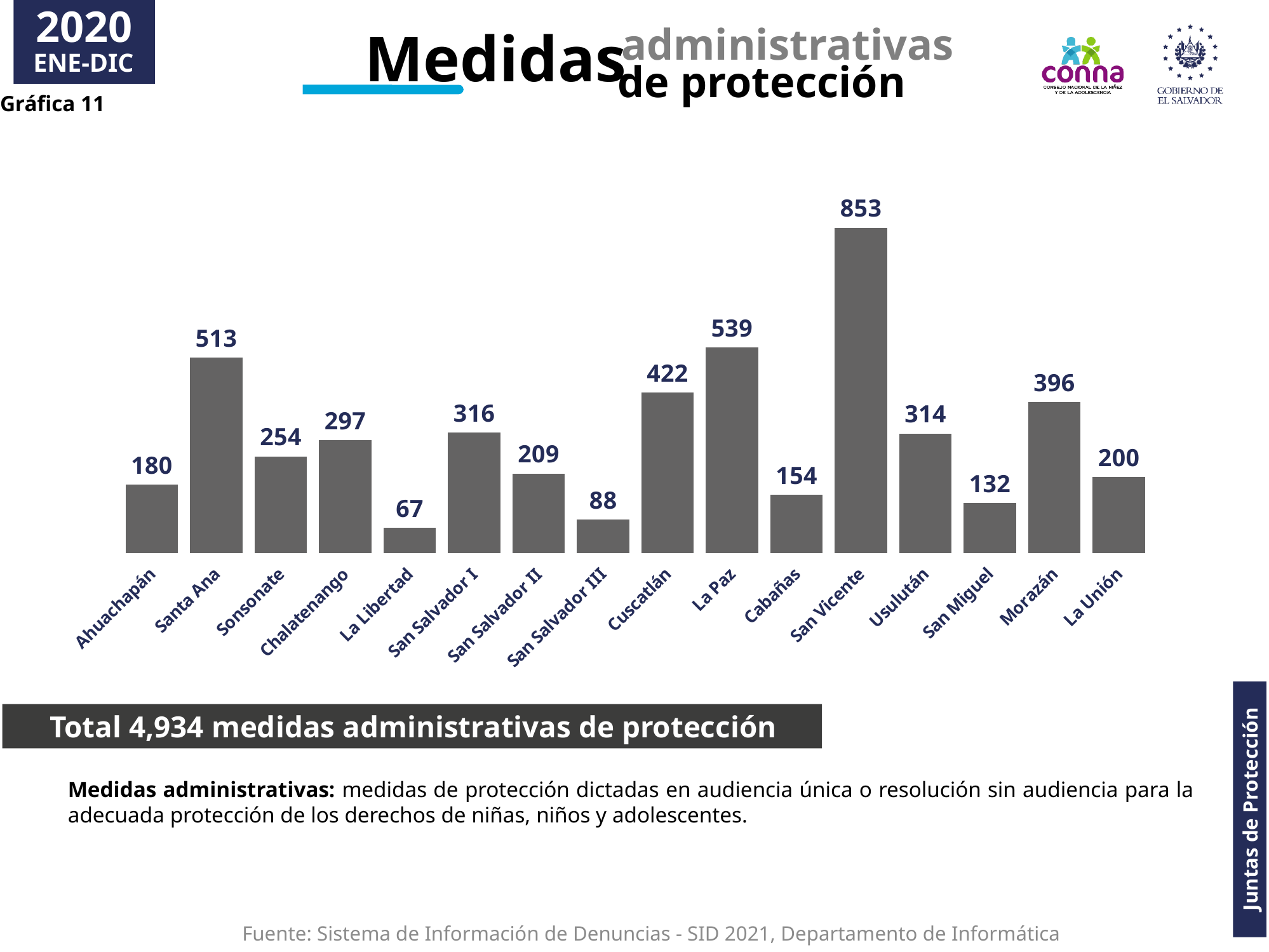
Which department has the highest value? San Vicente What total is stated below the chart? 4,934 medidas administrativas de protección What is the value for La Libertad? 67 What is the value for Cuscatlán? 422 What is the difference between the values for San Vicente and Morazán? 457 Which is larger, the value for Cabañas or the value for San Miguel? Cabañas How many departments are shown on the chart? 16 Which is larger, the value for Usulután or the value for San Salvador I? San Salvador I Which department has the lowest value? La Libertad What is the difference between the values for La Paz and Santa Ana? 26 What is the value for San Vicente? 853 What kind of chart is shown on the slide? Bar chart